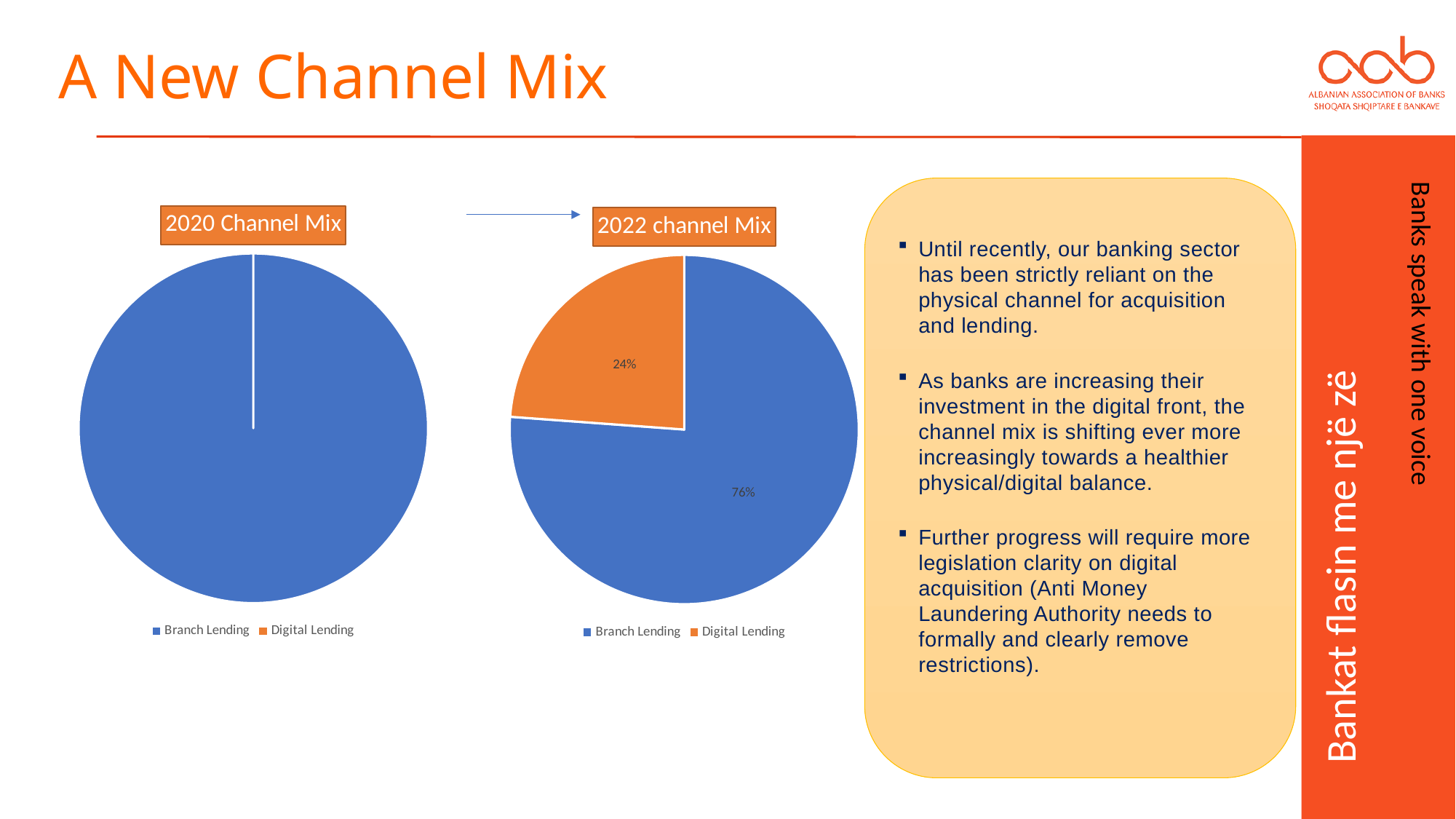
How many entries does the legend of the 2022 channel Mix chart list? 2 In the 2022 channel Mix pie chart, what colour is the Digital Lending slice? Orange In the 2022 channel Mix pie chart, by how many percentage points does Branch Lending exceed Digital Lending? 52 percentage points In the 2022 channel Mix pie chart, what share is labelled for Branch Lending? 76% In the 2022 channel Mix pie chart, which slice is the largest? Branch Lending In the 2022 channel Mix pie chart, what share is labelled for Digital Lending? 24% In the 2022 channel Mix pie chart, which slice is the smallest? Digital Lending What are the two legend entries shown under the 2020 Channel Mix chart? Branch Lending and Digital Lending In the 2022 channel Mix pie chart, which is larger: Branch Lending or Digital Lending? Branch Lending Is the Digital Lending slice visibly larger in the 2020 Channel Mix chart or the 2022 channel Mix chart? 2022 channel Mix In the 2020 Channel Mix pie chart, which category makes up essentially the whole pie? Branch Lending What kind of chart is the 2022 channel Mix chart? Pie chart